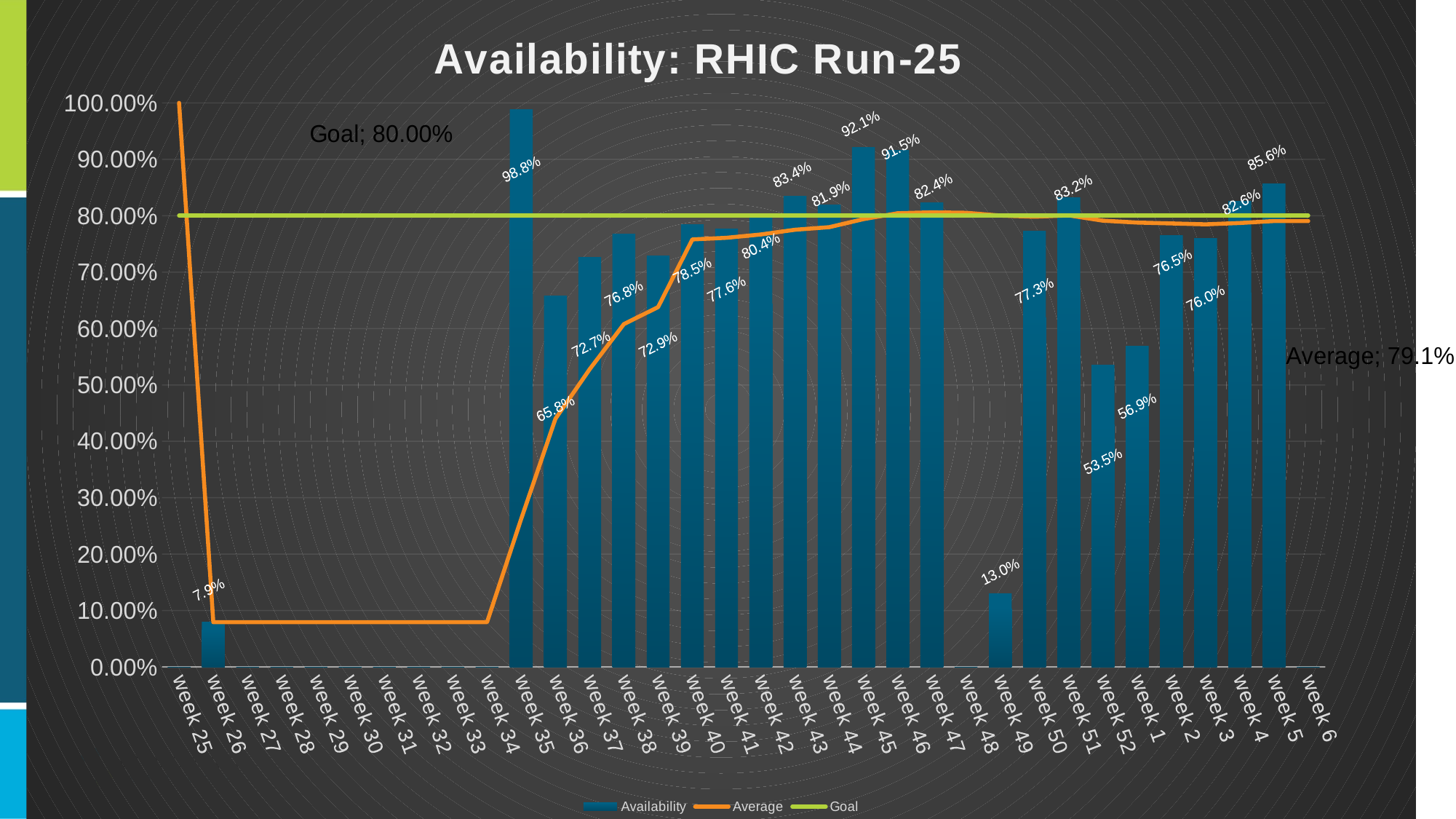
Which has the higher availability, week 43 or week 44? week 43 Is the availability value for week 1 greater or less than 60%? less What kind of chart is used for the Availability series? bar chart What is the availability value for week 49? 13.0% What is the difference between the availability for week 45 and week 46? 0.6% What goal value is shown on the chart? 80.00% What is the availability value for week 52? 53.5% How many weeks are shown on the x axis? 34 What average value is shown on the chart? 79.1% How many series does the legend list? 3 Which week has the highest availability? week 35 What is the availability value for week 45? 92.1%